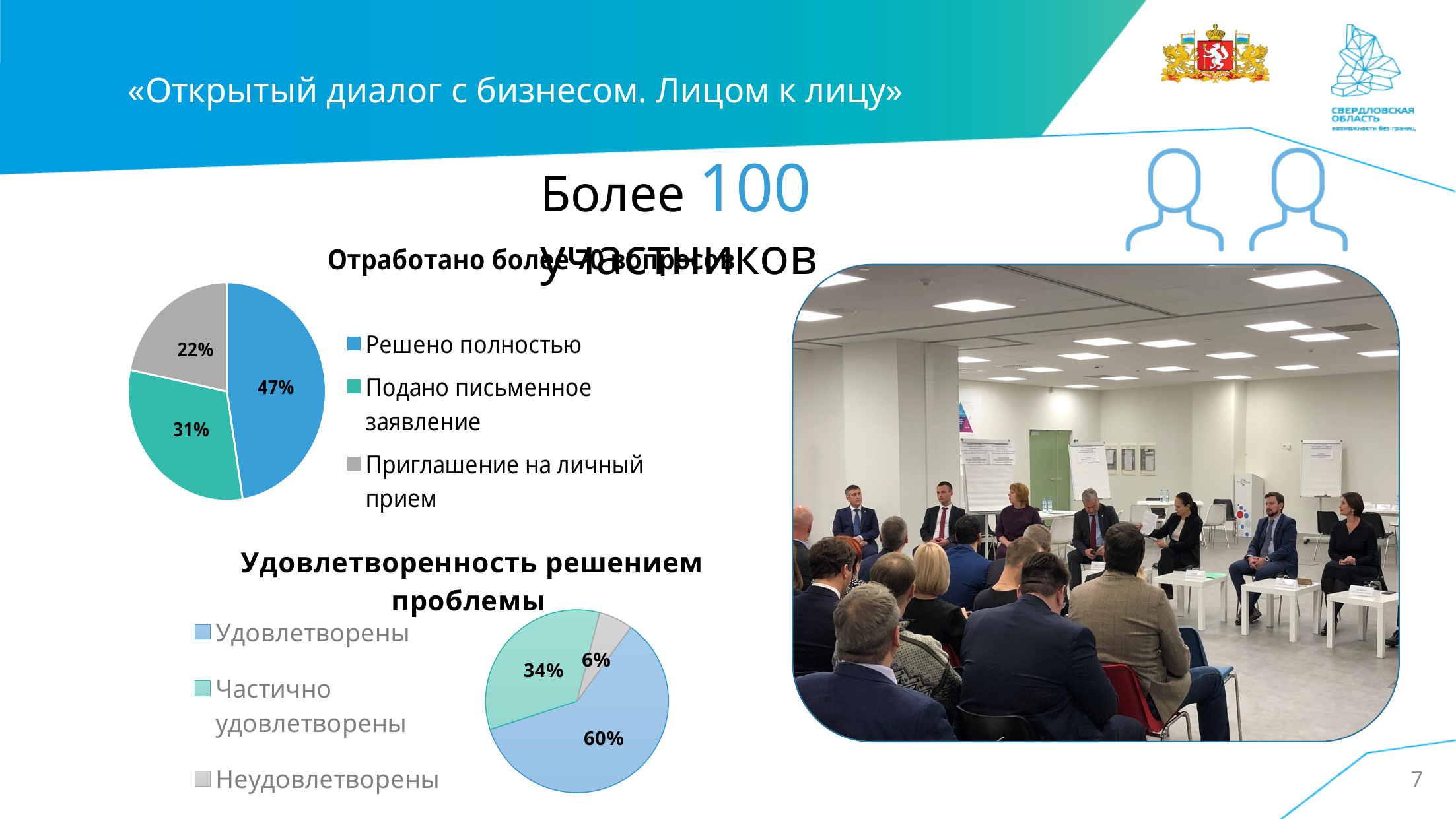
In the bottom pie chart "Удовлетворенность решением проблемы", what share is labelled for "Частично удовлетворены"? 34% In the bottom pie chart "Удовлетворенность решением проблемы", how many categories does the legend list? 3 In the bottom pie chart "Удовлетворенность решением проблемы", which category has the smallest slice? Неудовлетворены In the top pie chart, which category has the largest slice? Решено полностью In the top pie chart, what share is labelled for "Решено полностью"? 47% In the bottom pie chart "Удовлетворенность решением проблемы", what share is labelled for "Неудовлетворены"? 6% In the top pie chart, which category has the smallest slice? Приглашение на личный прием In the bottom pie chart "Удовлетворенность решением проблемы", what share is labelled for "Удовлетворены"? 60% In the top pie chart, what share is labelled for "Приглашение на личный прием"? 22% What type of chart is the bottom chart "Удовлетворенность решением проблемы"? Pie chart In the top pie chart, what is the difference in percentage points between "Решено полностью" and "Приглашение на личный прием"? 25 In the top pie chart, what share is labelled for "Подано письменное заявление"? 31%